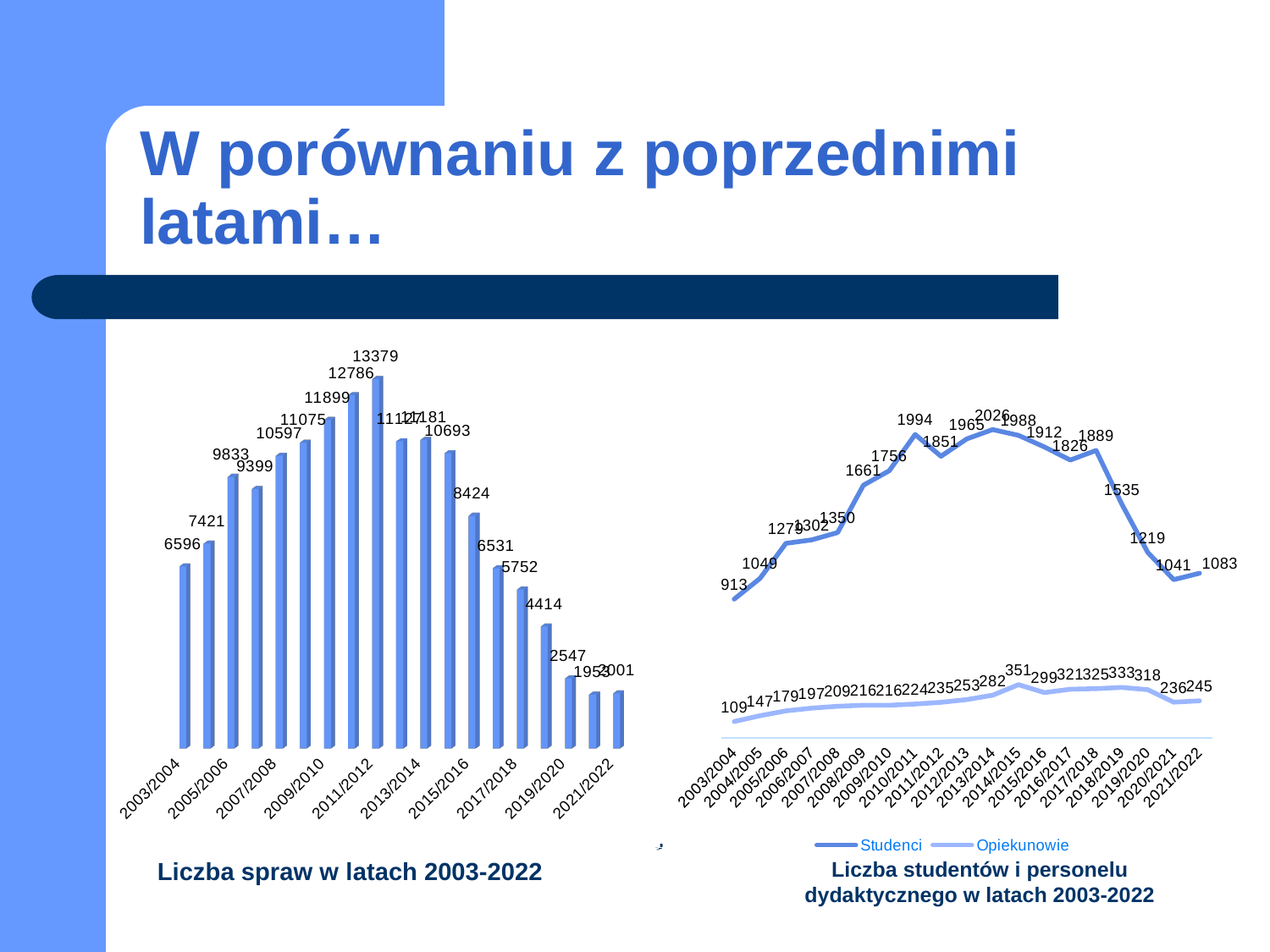
How many series does the legend of the right chart 'Liczba studentów i personelu dydaktycznego w latach 2003-2022' list? 2 In the left chart 'Liczba spraw w latach 2003-2022', do the values rise or fall from 2011/2012 to 2021/2022? fall What kind of chart is the left chart, 'Liczba spraw w latach 2003-2022'? bar chart In the left chart 'Liczba spraw w latach 2003-2022', which year has the highest number of cases? 2011/2012 In the right chart 'Liczba studentów i personelu dydaktycznego w latach 2003-2022', which is larger for Studenci: the value for 2003/2004 or the value for 2021/2022? 2021/2022 In the right chart 'Liczba studentów i personelu dydaktycznego w latach 2003-2022', what is the Studenci value for 2003/2004? 913 In the left chart 'Liczba spraw w latach 2003-2022', what is the value for 2003/2004? 6596 In the right chart 'Liczba studentów i personelu dydaktycznego w latach 2003-2022', what is the Opiekunowie value for 2021/2022? 245 What kind of chart is the right chart, 'Liczba studentów i personelu dydaktycznego w latach 2003-2022'? line chart In the right chart 'Liczba studentów i personelu dydaktycznego w latach 2003-2022', in which year is the Opiekunowie value lowest? 2003/2004 In the left chart 'Liczba spraw w latach 2003-2022', what is the difference between the values for 2003/2004 and 2019/2020? 4049 In the left chart 'Liczba spraw w latach 2003-2022', what is the value for 2019/2020? 2547